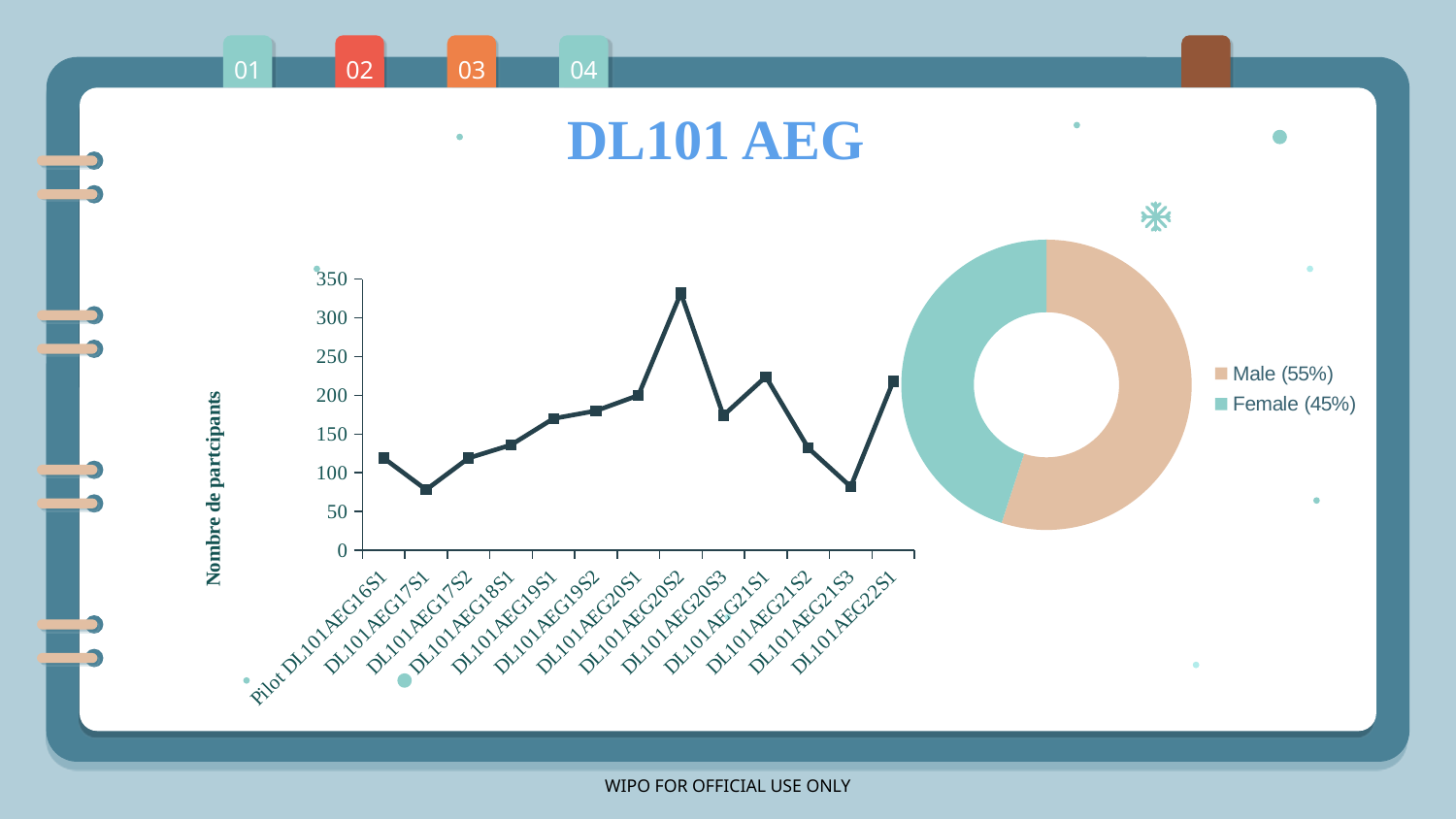
In the line chart, which is larger, the value for DL101AEG21S1 or DL101AEG21S2? DL101AEG21S1 In the line chart, which is larger, the value for DL101AEG20S2 or DL101AEG20S3? DL101AEG20S2 What is the y-axis title of the line chart? Nombre de partcipants In the line chart, is the value for DL101AEG17S1 greater or less than 100? less In the line chart, how many categories are shown on the x axis? 13 What kind of chart is the chart on the left of the slide? line chart In the pie chart, what share is Female? 45% In the pie chart, what share is Male? 55% In the line chart, which category has the highest value? DL101AEG20S2 What kind of chart is the chart on the right of the slide? pie chart (donut) In the line chart, is the value for DL101AEG20S2 greater or less than 300? greater In the line chart, is the value for DL101AEG21S1 greater or less than 200? greater